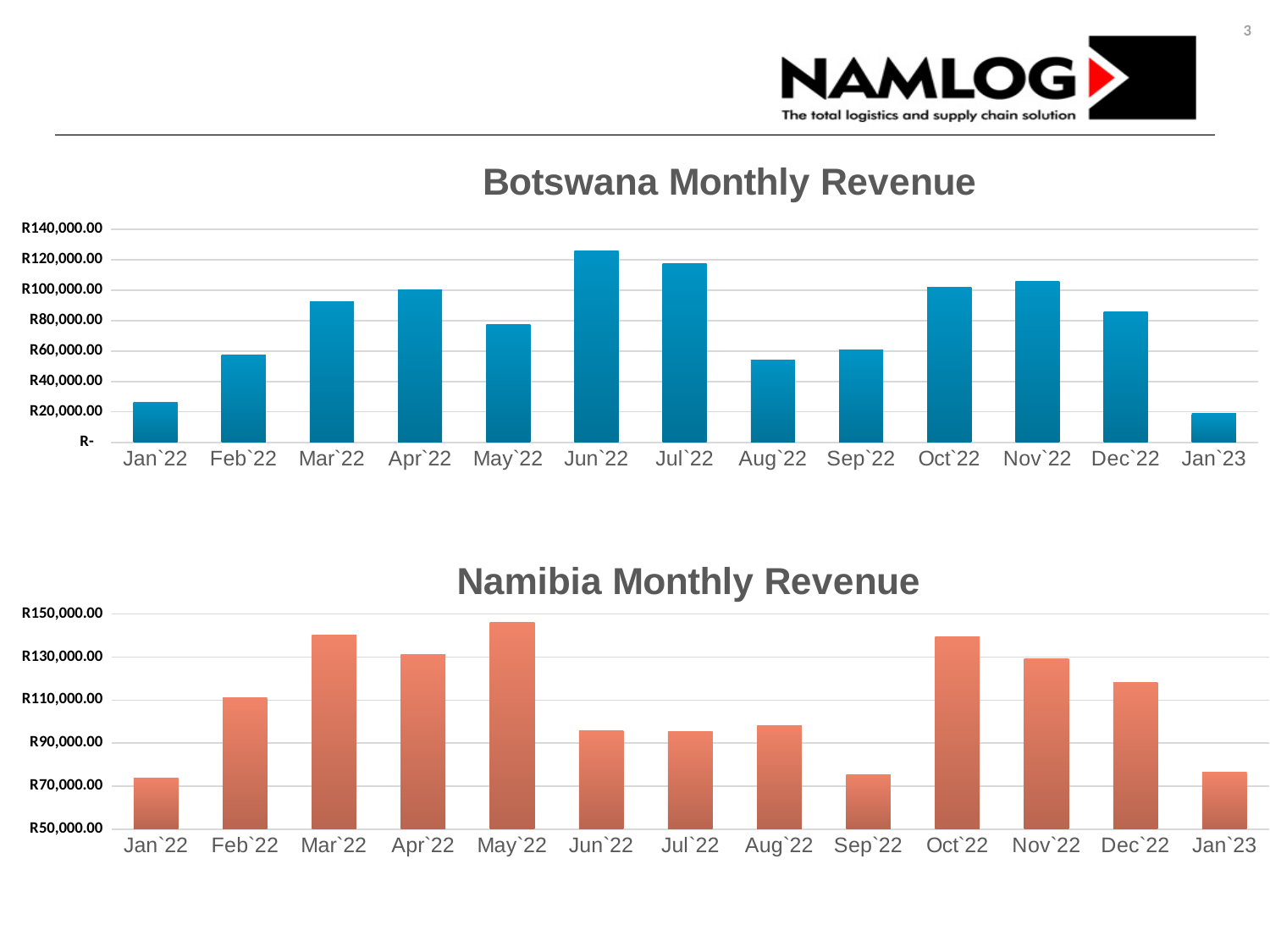
What kind of chart is the Botswana Monthly Revenue chart? bar chart In the Botswana Monthly Revenue chart, is the value for Jun`22 greater or less than R120,000.00? greater How many months are shown on the x axis of the Botswana Monthly Revenue chart? 13 In the Namibia Monthly Revenue chart, do the values rise or fall from Jan`22 to Mar`22? rise In the Botswana Monthly Revenue chart, which month has the lowest revenue? Jan`23 In the Namibia Monthly Revenue chart, which month has the highest revenue? May`22 In the Botswana Monthly Revenue chart, which is larger, the value for Mar`22 or the value for May`22? Mar`22 In the Botswana Monthly Revenue chart, is the value for Aug`22 greater or less than R60,000.00? less In the Namibia Monthly Revenue chart, which is larger, the value for Feb`22 or the value for Jun`22? Feb`22 In the Botswana Monthly Revenue chart, which month has the highest revenue? Jun`22 In the Namibia Monthly Revenue chart, is the value for Sep`22 greater or less than R90,000.00? less